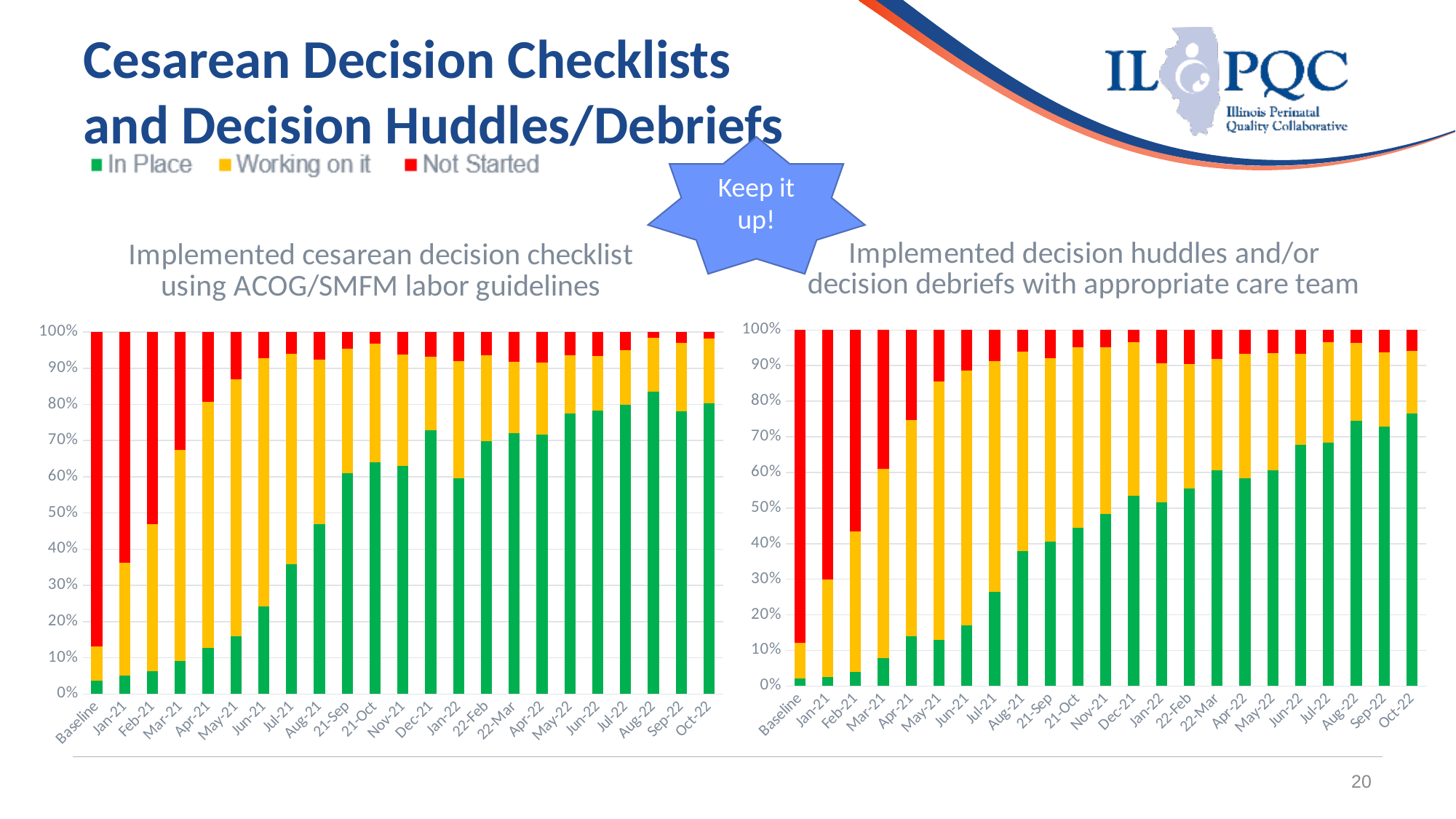
In the left chart (cesarean decision checklist), is the 'In Place' value for Oct-22 greater or less than 70%? greater In the left chart (cesarean decision checklist), does the 'In Place' share generally rise or fall from Baseline to Oct-22? Rise In the right chart (decision huddles and/or decision debriefs), is the 'In Place' value for Baseline greater or less than 10%? less What kind of chart is used on the left, titled 'Implemented cesarean decision checklist using ACOG/SMFM labor guidelines'? Stacked bar chart In the left chart (cesarean decision checklist), is the 'In Place' value for Baseline greater or less than 10%? less In the left chart (cesarean decision checklist), how many time-period categories are shown on the x axis? 23 What are the three series named in the legend? In Place, Working on it, Not Started In the left chart (cesarean decision checklist), which category has the largest 'Not Started' share? Baseline In the left chart (cesarean decision checklist), which is larger, the 'In Place' value for Jun-21 or for Jul-21? Jul-21 In the right chart (decision huddles and/or decision debriefs), which is larger, the 'Not Started' share for Baseline or for Oct-22? Baseline How many series does the legend list for the charts on this slide? 3